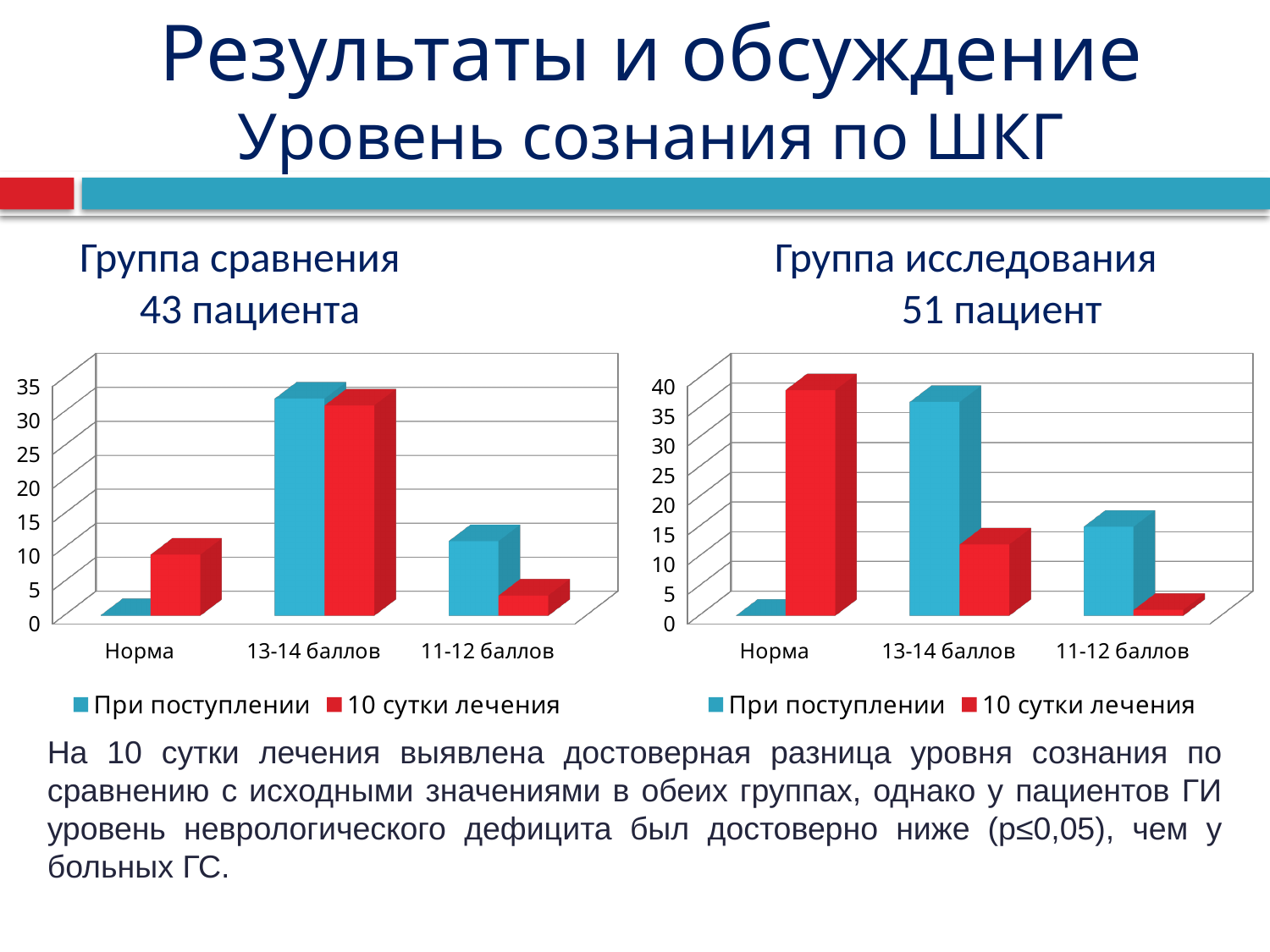
In the left chart (Группа сравнения), is the value for "11-12 баллов" in the series "10 сутки лечения" greater or less than 5? less In the right chart (Группа исследования), which category has the lowest value for the series "10 сутки лечения"? 11-12 баллов In the right chart (Группа исследования), is the value for "Норма" in the series "10 сутки лечения" greater or less than 35? greater How many series does the legend of the left chart list? 2 What colour represents the series "10 сутки лечения" in both charts? red How many categories are shown on the x axis of the right chart titled "Группа исследования 51 пациент"? 3 What kind of chart is the left chart titled "Группа сравнения 43 пациента"? bar chart In the right chart (Группа исследования), which is larger for "13-14 баллов": the value for "При поступлении" or for "10 сутки лечения"? При поступлении In the left chart (Группа сравнения), which category has the highest value for the series "При поступлении"? 13-14 баллов How many patients are stated in the title of the right chart (Группа исследования)? 51 пациент In the left chart (Группа сравнения), which is larger for "Норма": the value for "При поступлении" or for "10 сутки лечения"? 10 сутки лечения In the right chart (Группа исследования), which category has the highest value for the series "10 сутки лечения"? Норма